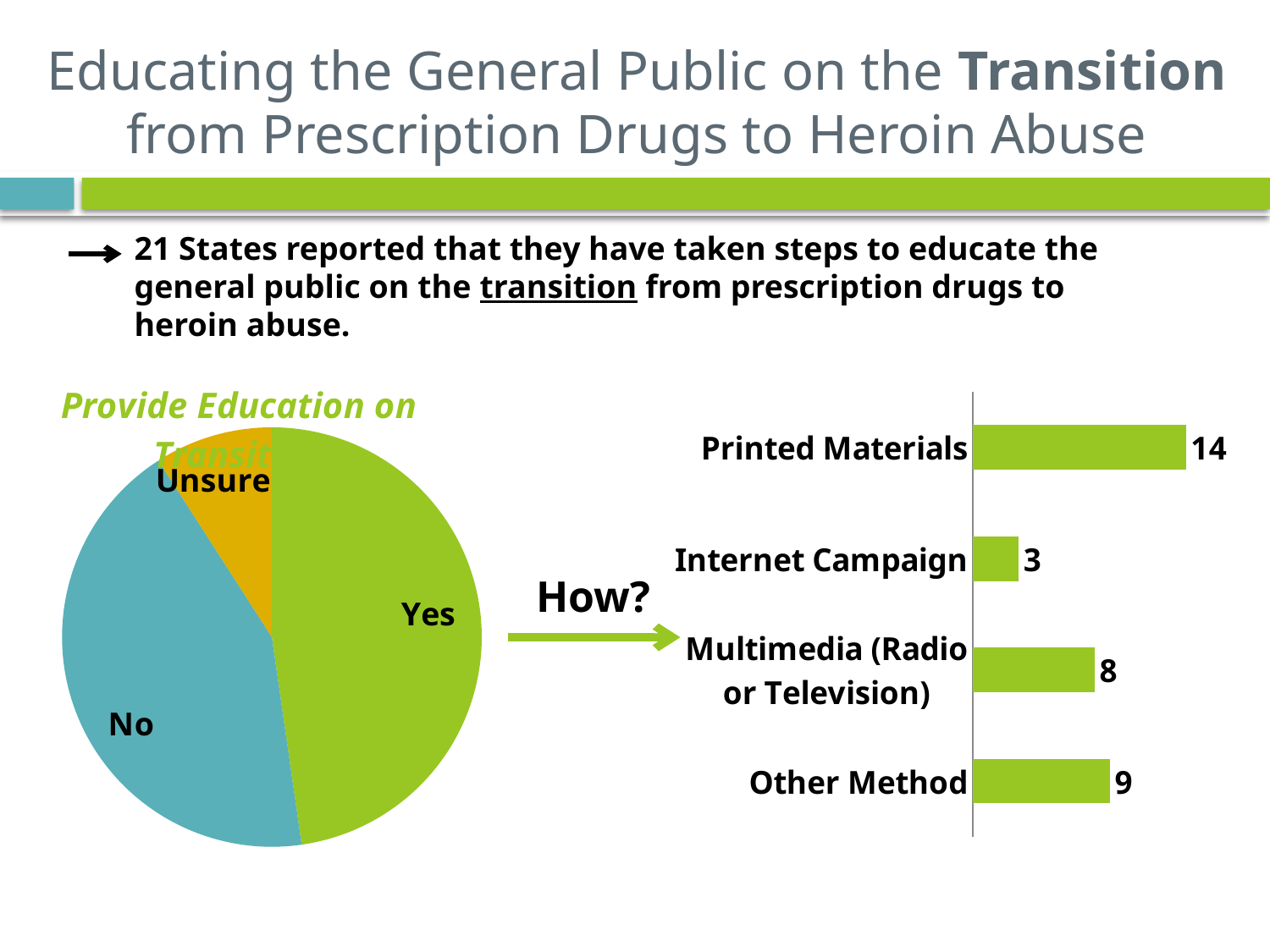
In the bar chart on the right, what is the value for Multimedia (Radio or Television)? 8 In the bar chart on the right, which method has the lowest value? Internet Campaign How many slices does the pie chart on the left have? 3 In the bar chart on the right, what is the value for Internet Campaign? 3 How many categories are shown in the bar chart on the right? 4 In the pie chart on the left, which slice is the smallest? Unsure In the pie chart on the left, which slice is the largest? Yes In the bar chart on the right, which is larger: Multimedia (Radio or Television) or Other Method? Other Method In the bar chart on the right, which method has the highest value? Printed Materials In the bar chart on the right, what is the value for Printed Materials? 14 In the bar chart on the right, what is the difference between Printed Materials and Other Method? 5 In the bar chart on the right, what is the value for Other Method? 9